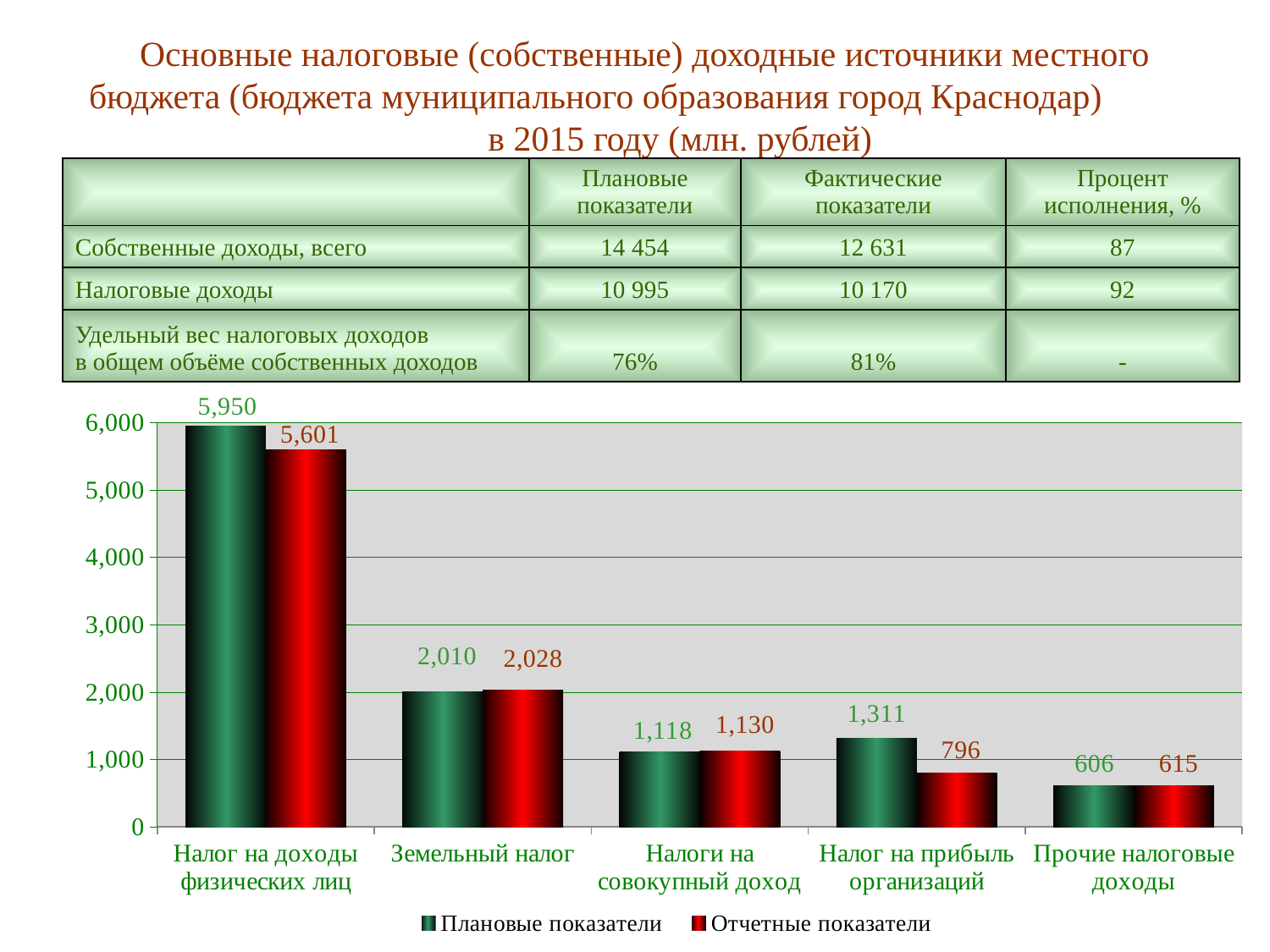
Which category has the highest planned value (Плановые показатели)? Налог на доходы физических лиц What is the difference between the planned and reported values for Налог на прибыль организаций? 515 What is the reported value (Отчетные показатели) for Земельный налог? 2,028 What is the reported value (Отчетные показатели) for Налог на прибыль организаций? 796 How many categories are shown on the x axis of the chart? 5 Which category has the lowest reported value (Отчетные показатели)? Прочие налоговые доходы Which colour represents Отчетные показатели in the chart? Red What is the difference between the planned and reported values for Налог на доходы физических лиц? 349 How many series does the chart legend list? 2 For Налоги на совокупный доход, which is larger: the planned value or the reported value? Reported value (1,130) What kind of chart is shown on the slide? Bar chart What is the planned value (Плановые показатели) for Налог на доходы физических лиц? 5,950